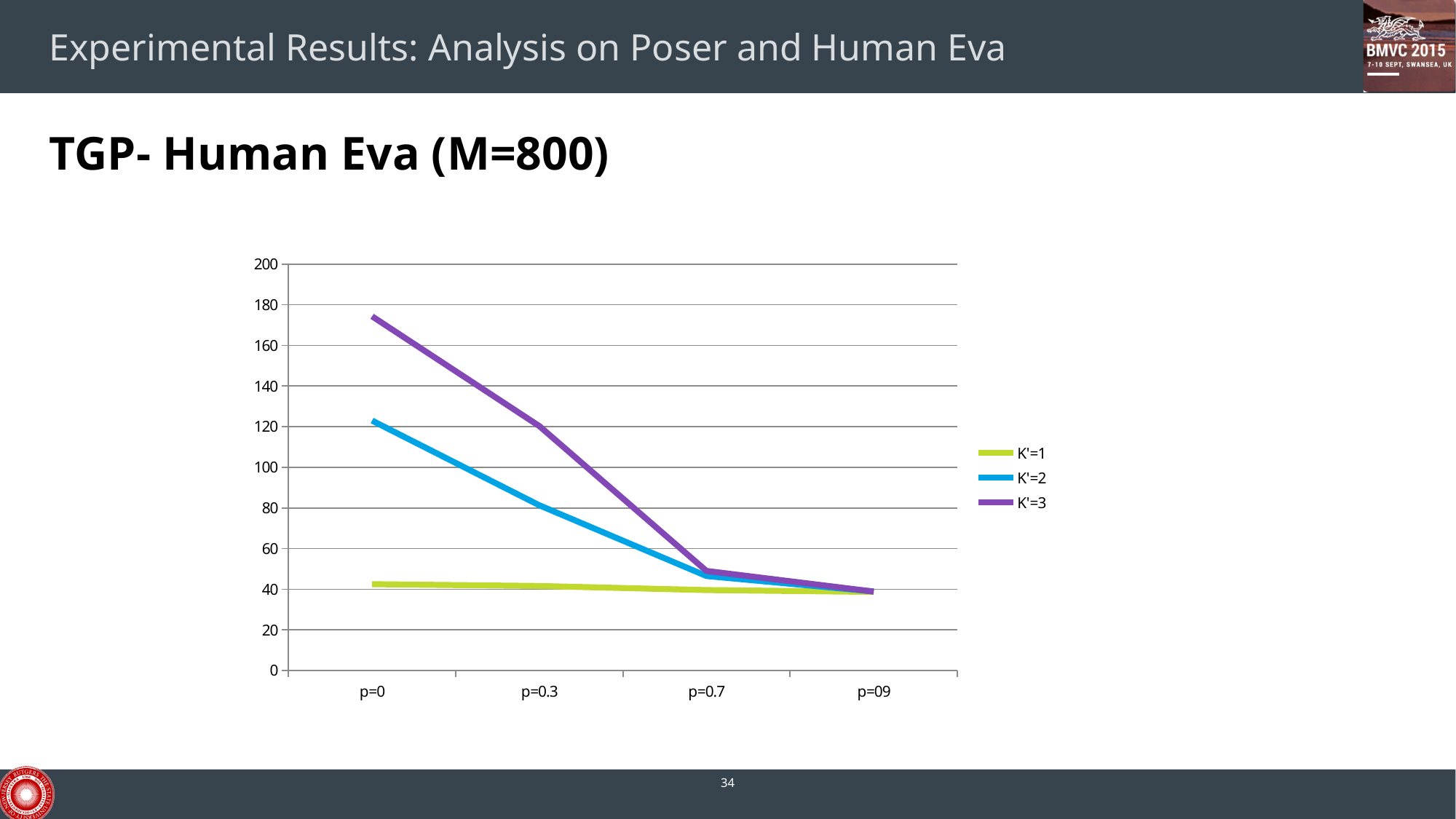
Which series has the highest value at p=0? K'=3 Does the K'=3 series rise or fall from p=0 to p=09? fall What kind of chart is shown on the slide? line chart What is the title shown above the chart? TGP- Human Eva (M=800) Is the value for K'=1 at p=0 greater or less than 60? less Is the value for K'=2 at p=0 greater or less than 100? greater Is the value for K'=3 at p=0 greater or less than 160? greater At p=0.3, which is larger: the value for K'=2 or the value for K'=3? K'=3 What colour is the line for the K'=2 series? blue Which series has the lowest value at p=0? K'=1 How many points are plotted along the x axis for each series? 4 How many series does the legend list? 3